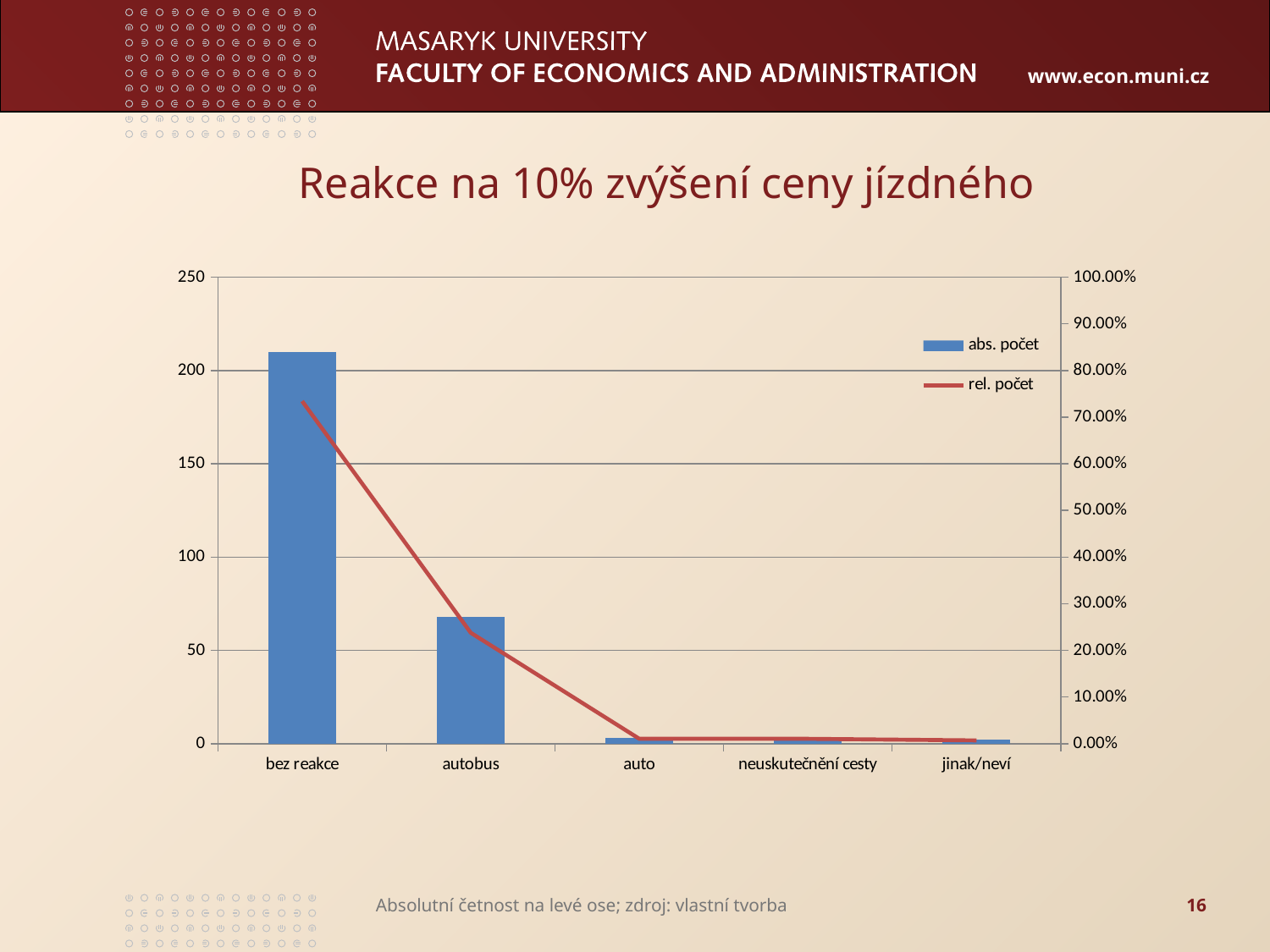
Is the abs. počet value for autobus greater or less than 50? greater How many series does the chart's legend list? 2 Which series is drawn as a line in the chart? rel. počet How many categories are shown on the x axis of the chart? 5 Which is larger, the abs. počet value for bez reakce or for autobus? bez reakce Do the rel. počet values rise or fall from bez reakce to auto along the x axis? fall Is the rel. počet value for autobus greater or less than 30.00%? less What is the title of the chart? Reakce na 10% zvýšení ceny jízdného Is the abs. počet value for bez reakce greater or less than 200? greater Which category has the highest value for abs. počet? bez reakce